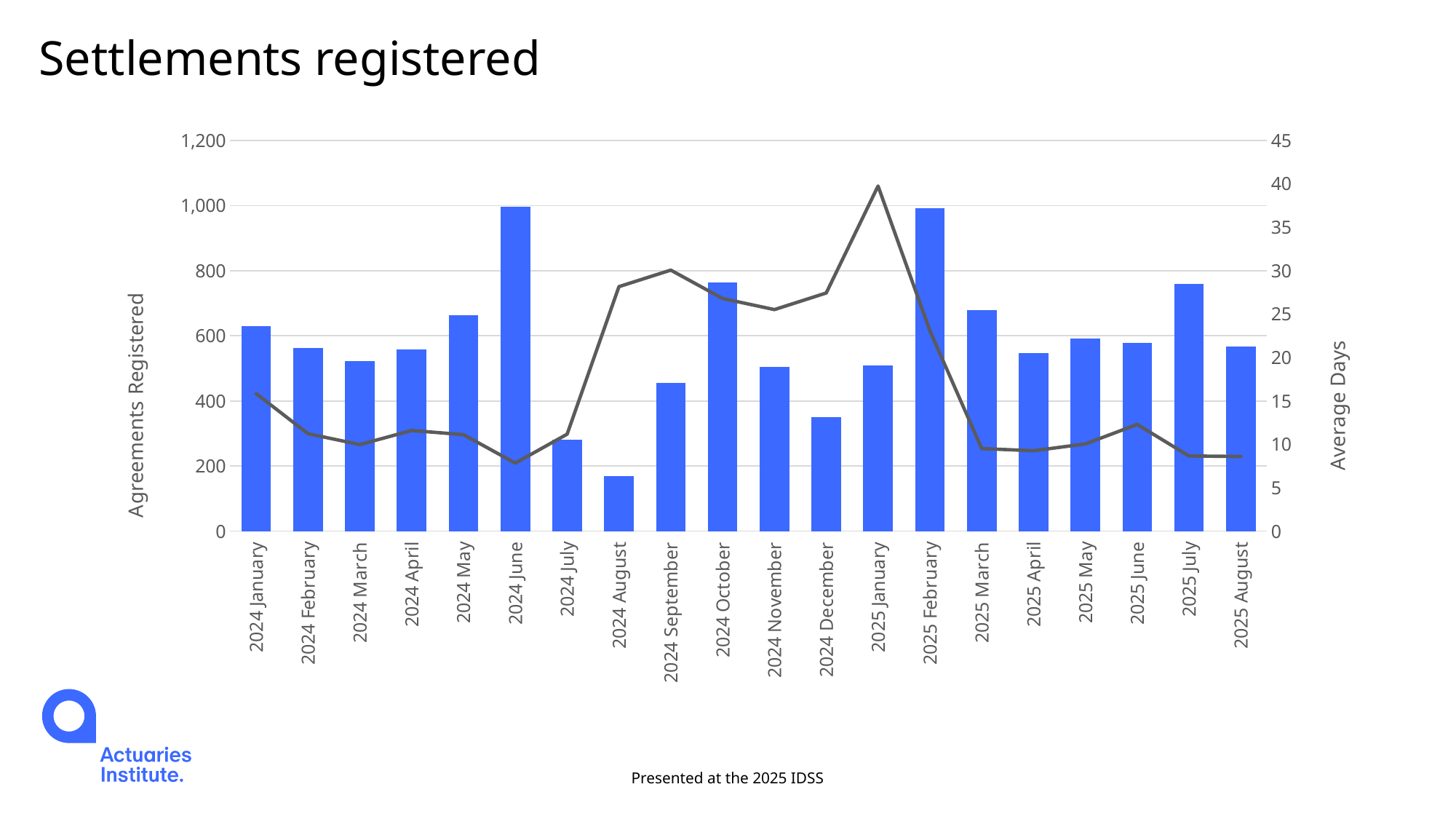
What is the title of the right-hand vertical axis? Average Days Do the agreements registered rise or fall from 2024 January to 2024 March? fall Is the average days value for 2025 January greater or less than 35? greater Which month has more agreements registered, 2024 May or 2024 March? 2024 May Which month has the lowest number of agreements registered? 2024 August Is the number of agreements registered in 2024 June greater or less than 800? greater What kind of chart is shown on the slide? A bar chart with a line overlay How many months are shown along the x axis? 20 Is the number of agreements registered in 2025 July greater or less than 600? greater Which month has the highest average days on the line? 2025 January